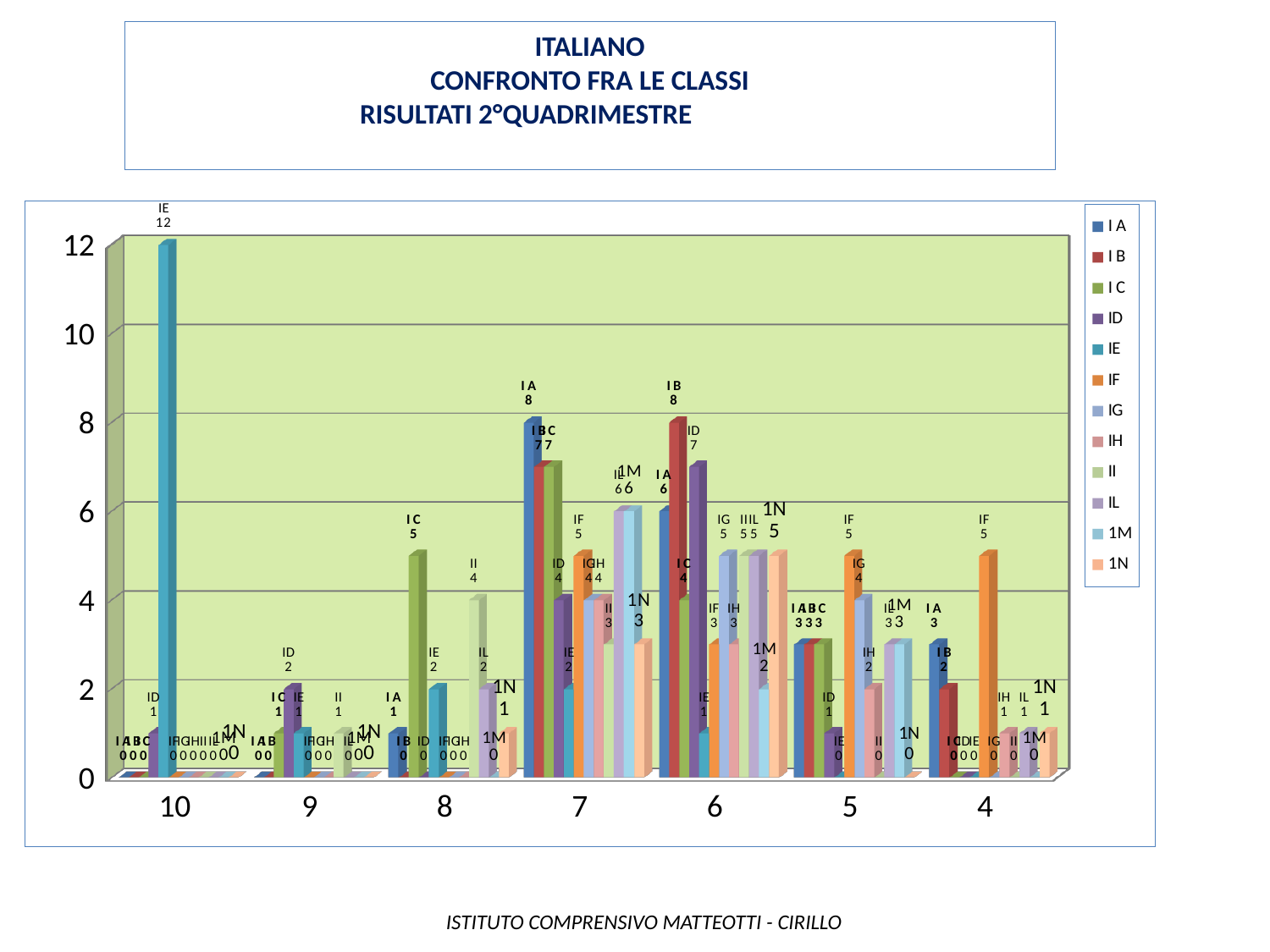
What is the value for IE at grade 10? 12 How many series does the legend list? 12 Which series has the highest bar at grade 7? I A Is the value for IE at grade 10 greater or less than 10? greater What is the value for I B at grade 6? 8 What kind of chart is shown on the slide? Bar chart What is the first line of the chart's title? ITALIANO What is the difference between the value for IE and the value for ID at grade 10? 11 How many categories are shown on the x axis? 7 At grade 5, which is larger: the value for IF or the value for IG? IF What is the value for I C at grade 8? 5 What is the value for ID at grade 6? 7